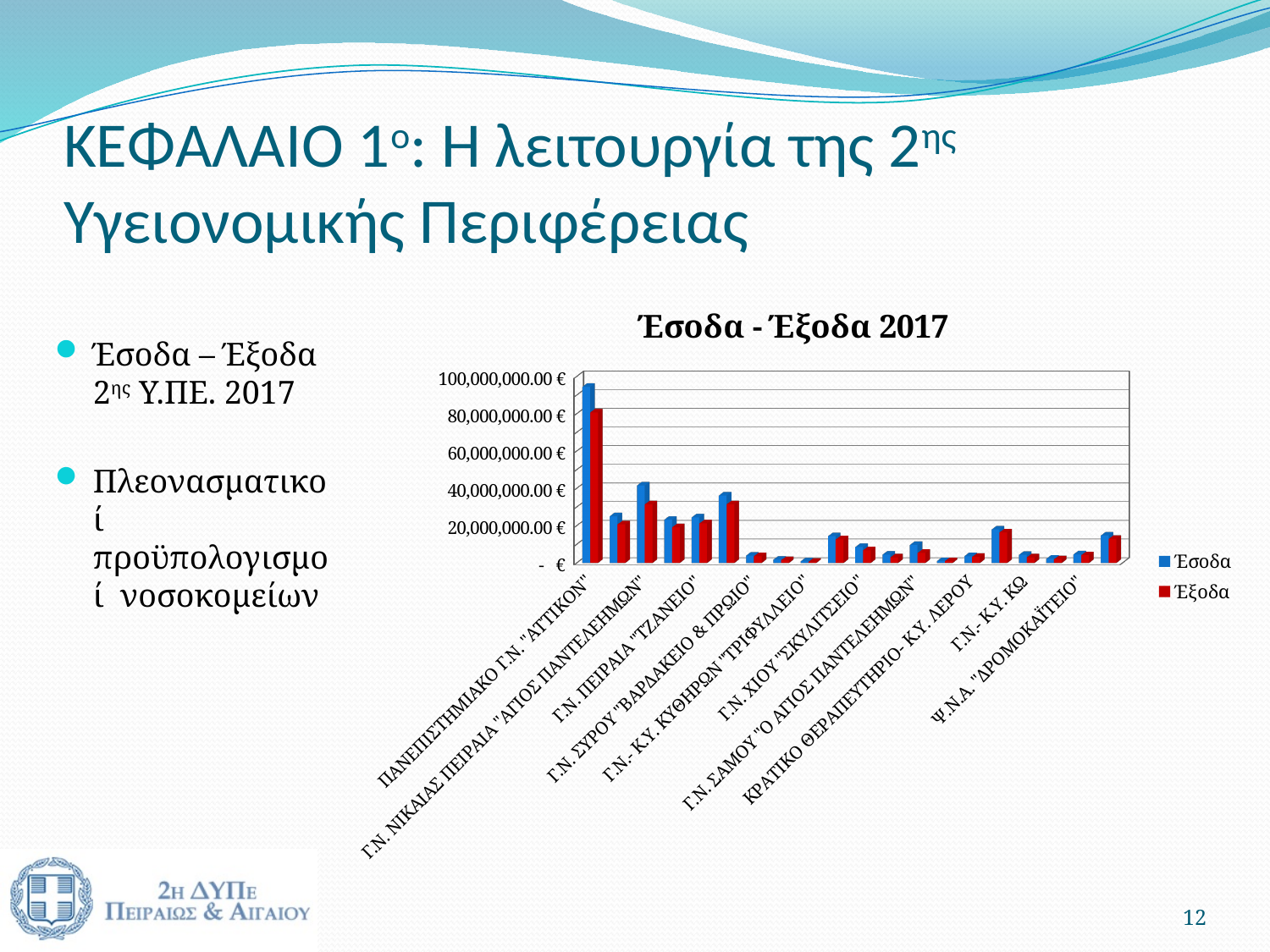
How many series does the chart's legend list? 2 What is the title of the chart? Έσοδα - Έξοδα 2017 Which hospital has the highest Έσοδα value in the chart? ΠΑΝΕΠΙΣΤΗΜΙΑΚΟ Γ.Ν. "ΑΤΤΙΚΟΝ" Is the Έξοδα value for ΠΑΝΕΠΙΣΤΗΜΙΑΚΟ Γ.Ν. "ΑΤΤΙΚΟΝ" greater or less than 60,000,000.00 €? greater Which series is shown in red in the chart? Έξοδα Is the Έσοδα value for ΠΑΝΕΠΙΣΤΗΜΙΑΚΟ Γ.Ν. "ΑΤΤΙΚΟΝ" greater or less than 80,000,000.00 €? greater Which hospital has the highest Έξοδα value in the chart? ΠΑΝΕΠΙΣΤΗΜΙΑΚΟ Γ.Ν. "ΑΤΤΙΚΟΝ" What is the highest value shown on the chart's vertical axis? 100,000,000.00 € What kind of chart is shown on the slide? bar chart For ΠΑΝΕΠΙΣΤΗΜΙΑΚΟ Γ.Ν. "ΑΤΤΙΚΟΝ", which is larger, Έσοδα or Έξοδα? Έσοδα